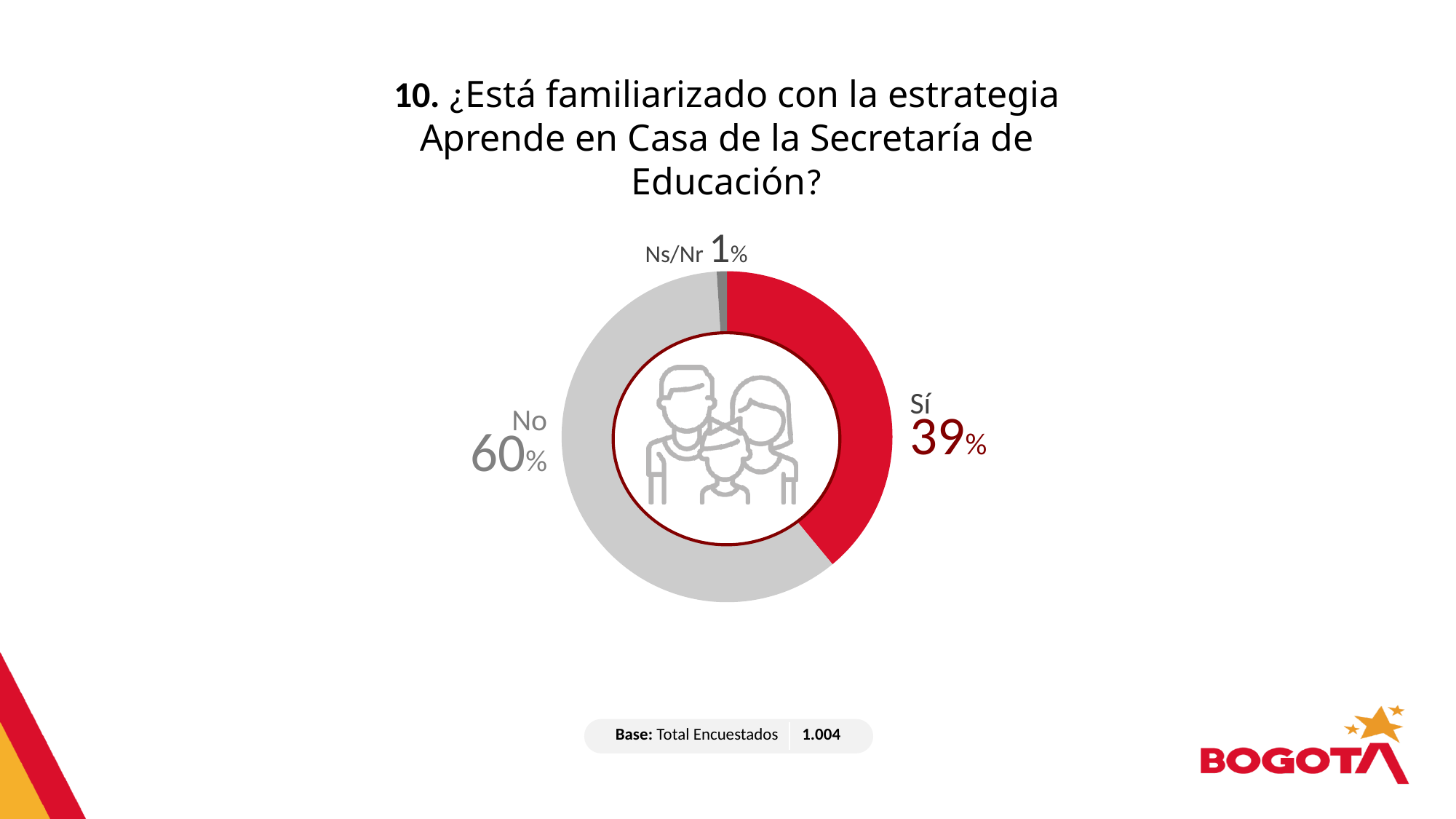
What percentage of respondents answered "No"? 60% What is the combined share of the "Sí" and "Ns/Nr" responses? 40% What colour is the "Sí" segment of the chart? Red Which response has the smallest share of the chart? Ns/Nr Which response has the largest share of the chart? No What kind of chart is shown on the slide? Pie chart (donut) What percentage of respondents answered "Sí"? 39% How many response categories are shown in the chart? 3 What percentage of respondents answered "Ns/Nr"? 1% What is the base (total number of respondents) shown below the chart? 1.004 What is the difference in percentage points between the "No" and "Sí" responses? 21 Which is larger, the share for "Sí" or the share for "No"? No